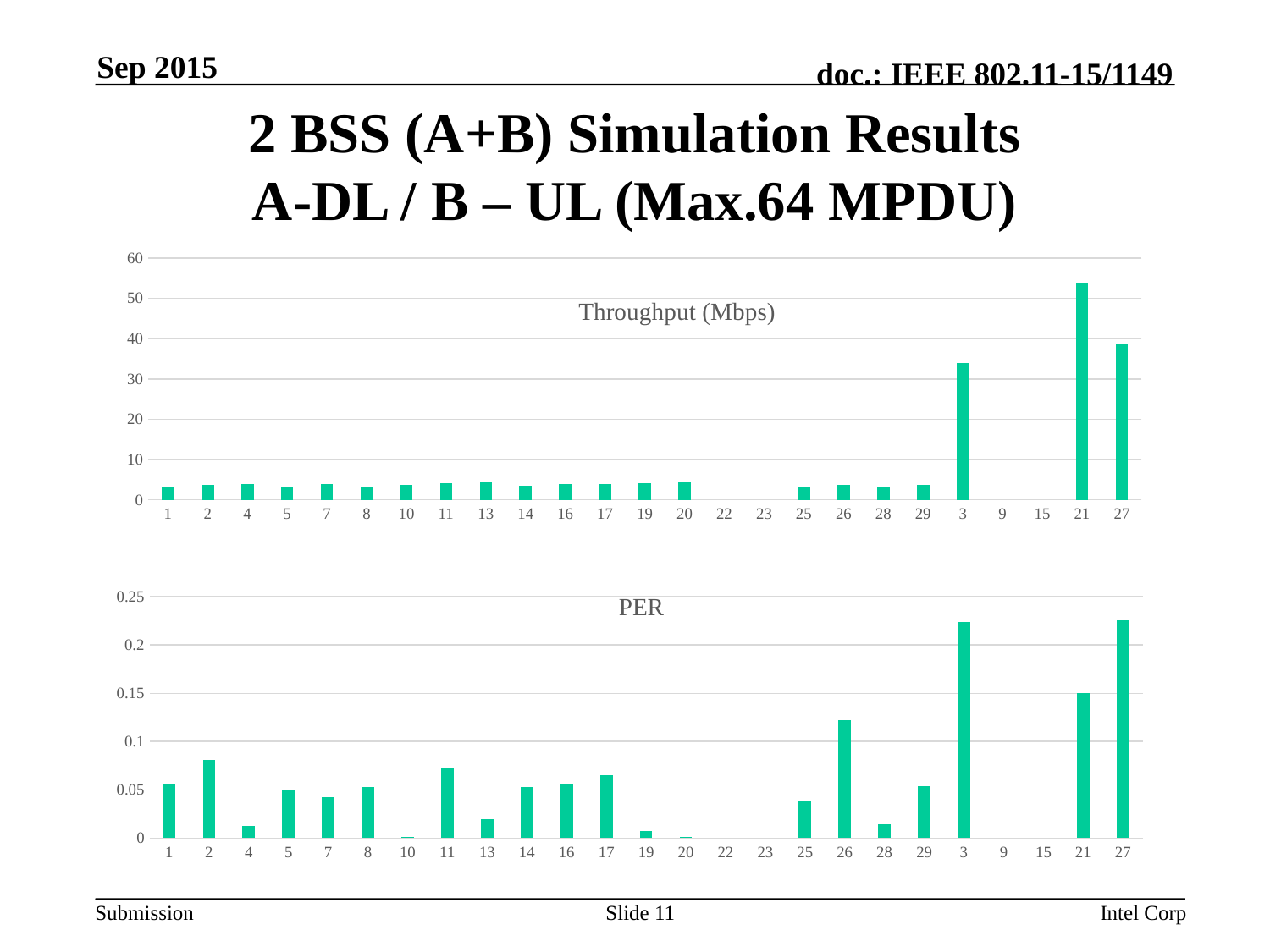
In the PER chart, is the value for category 4 greater or less than 0.05? less In the PER chart, is the value for category 21 greater or less than 0.1? greater In the Throughput (Mbps) chart, which category has the highest value? 21 How many categories are shown on the x axis of the Throughput (Mbps) chart? 25 In the Throughput (Mbps) chart, is the value for category 21 greater or less than 50? greater In the Throughput (Mbps) chart, which is larger, the value for category 3 or category 27? 27 What kind of chart is the Throughput (Mbps) chart? bar chart In the PER chart, which is larger, the value for category 26 or category 21? 21 What is the title of the lower chart on the slide? PER